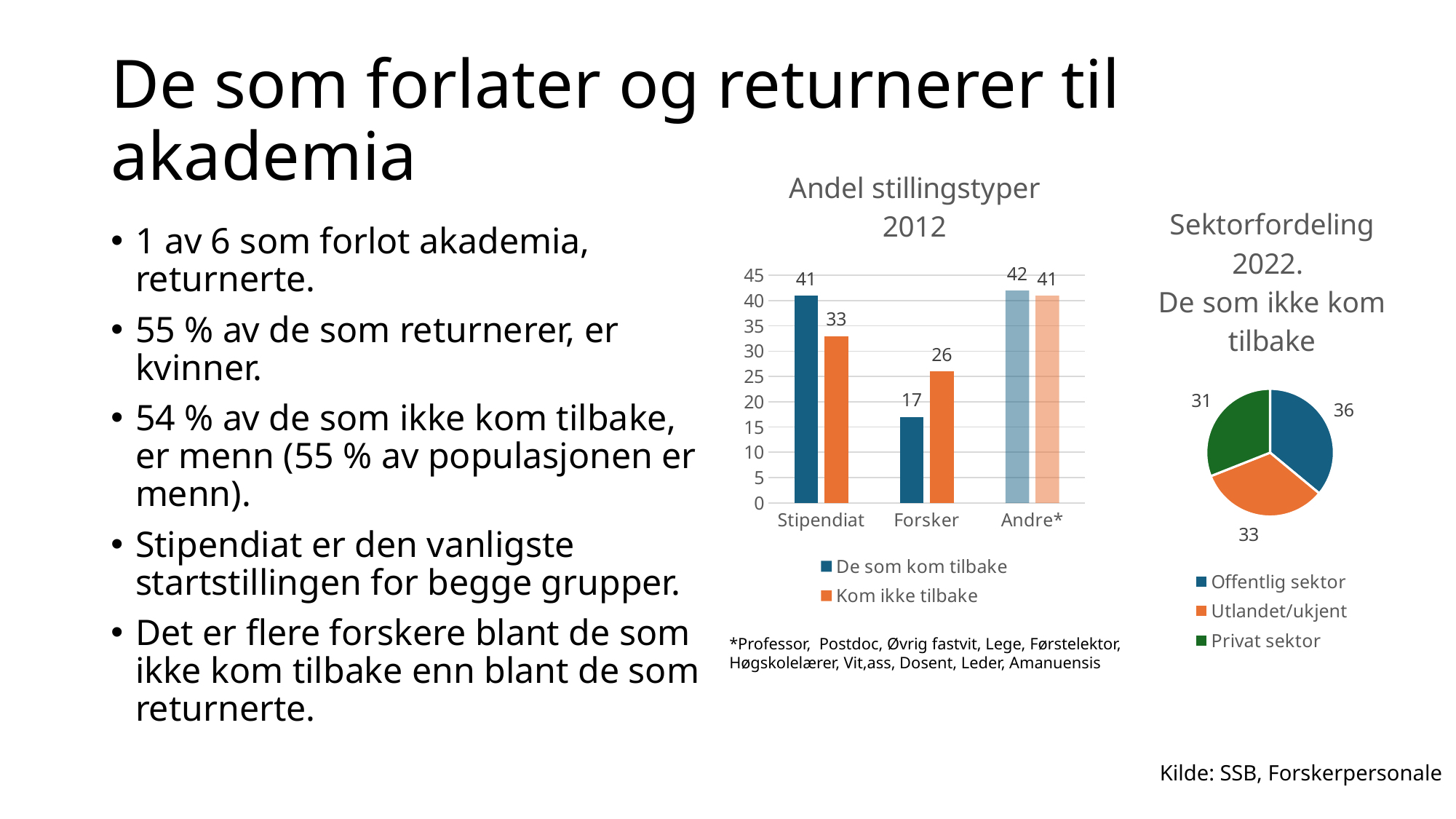
In the 'Andel stillingstyper 2012' chart, how many series does the legend list? 2 In the 'Sektorfordeling 2022' pie chart, which sector has the largest slice? Offentlig sektor In the 'Andel stillingstyper 2012' chart, what is the value for Forsker in the 'Kom ikke tilbake' series? 26 In the 'Andel stillingstyper 2012' chart, what is the value for Andre* in the 'De som kom tilbake' series? 42 In the 'Sektorfordeling 2022' pie chart, what is the value for Utlandet/ukjent? 33 In the 'Sektorfordeling 2022' pie chart, what share of the pie does Privat sektor represent? 31% In the 'Andel stillingstyper 2012' chart, what is the value for Stipendiat in the 'De som kom tilbake' series? 41 In the 'Andel stillingstyper 2012' chart, which category has the lowest value in the 'De som kom tilbake' series? Forsker In the 'Andel stillingstyper 2012' chart, what is the difference between 'De som kom tilbake' and 'Kom ikke tilbake' for Stipendiat? 8 What kind of chart is 'Andel stillingstyper 2012'? Bar chart In the 'Andel stillingstyper 2012' chart, how many categories are shown on the x axis? 3 In the 'Andel stillingstyper 2012' chart, which series has the larger value for Forsker? Kom ikke tilbake